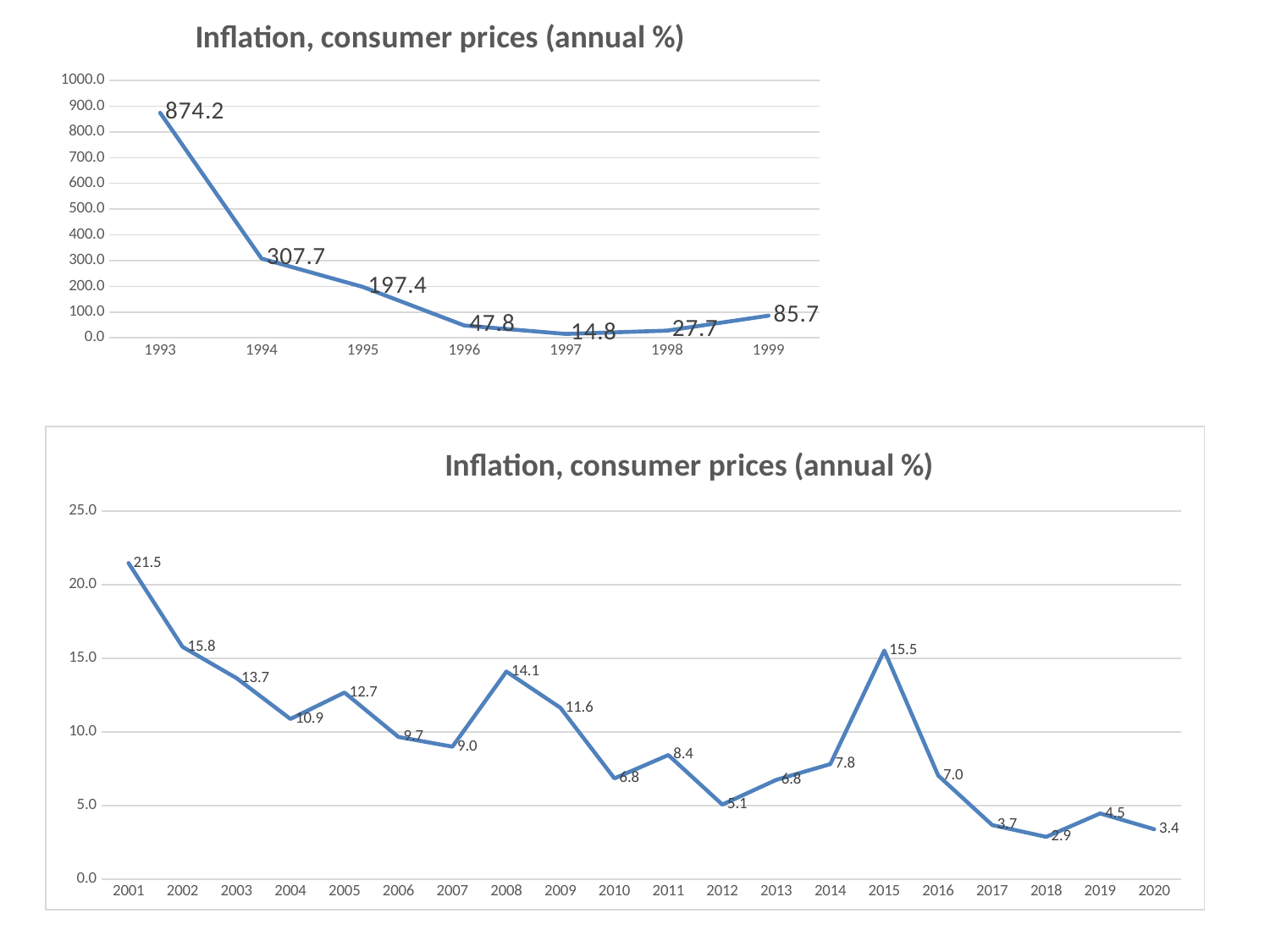
In the bottom chart (2001–2020), which is larger, the value for 2008 or the value for 2009? 2008 In the top chart (1993–1999), what kind of chart is shown? Line chart In the top chart (1993–1999), how many years are plotted? 7 What is the title of the bottom chart? Inflation, consumer prices (annual %) In the top chart (1993–1999), which year has the lowest inflation value? 1997 In the bottom chart (2001–2020), which year has the lowest inflation value? 2018 In the top chart (1993–1999), what is the difference between the 1994 and 1995 values? 110.3 In the top chart (1993–1999), what is the inflation value for 1993? 874.2 In the bottom chart (2001–2020), how many years are plotted? 20 In the bottom chart (2001–2020), what is the difference between the 2001 and 2002 values? 5.7 In the bottom chart (2001–2020), what is the inflation value for 2015? 15.5 In the bottom chart (2001–2020), which year has the highest inflation value? 2001